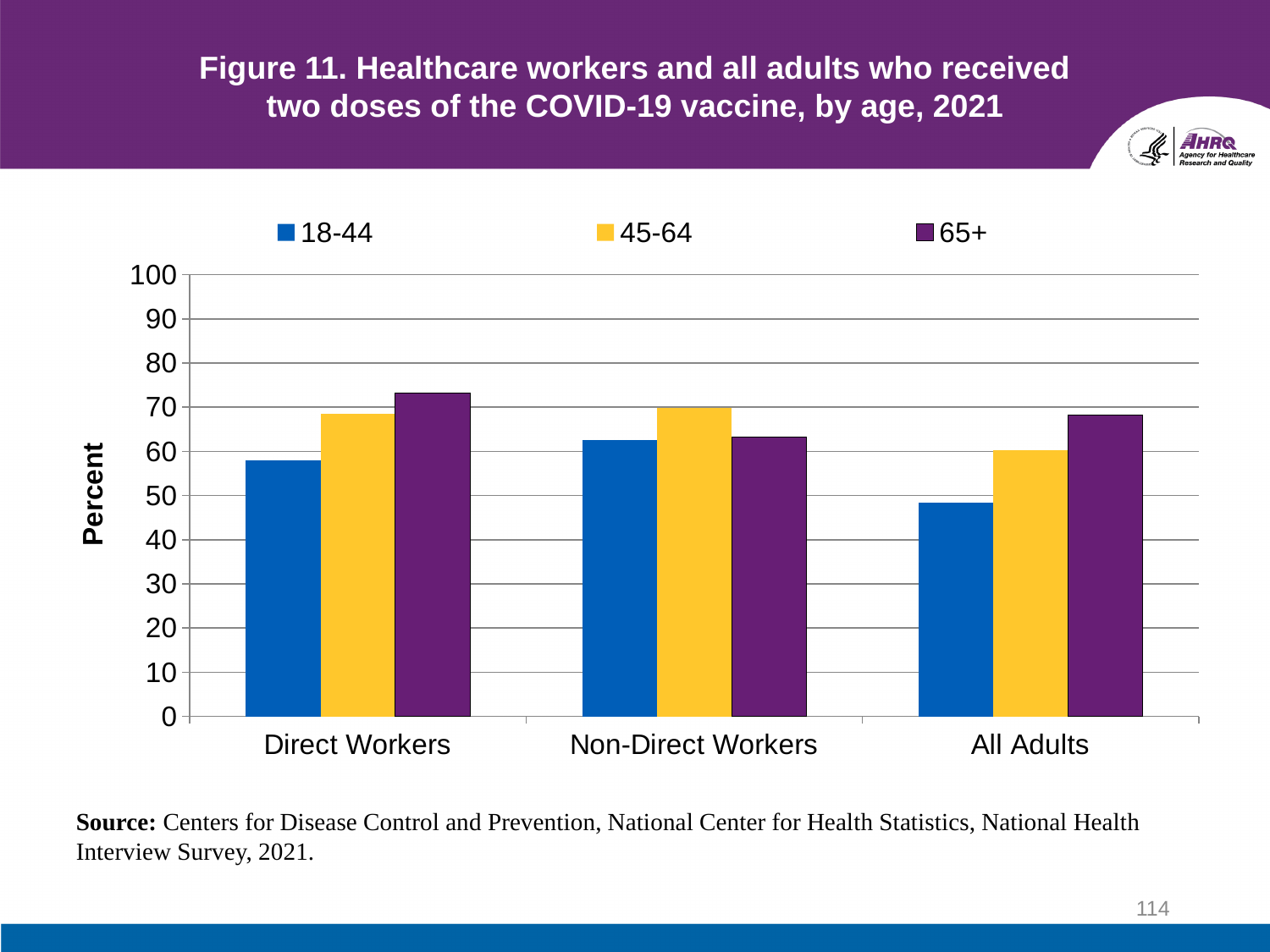
How many series does the legend list? 3 How many categories are shown on the x axis? 3 Among Non-Direct Workers, which is larger: the value for 45-64 or the value for 65+? 45-64 Is the value for 45-64 among Non-Direct Workers greater or less than 60? greater Is the value for 65+ among Direct Workers greater or less than 70? greater Is the value for 18-44 among All Adults greater or less than 60? less Which age group is shown in yellow in the legend? 45-64 For the 18-44 series, which category has the lowest value? All Adults What kind of chart is shown on the slide? bar chart What is the label of the y axis? Percent For the 65+ series, which category has the highest value? Direct Workers Among All Adults, which is larger: the value for 18-44 or the value for 65+? 65+